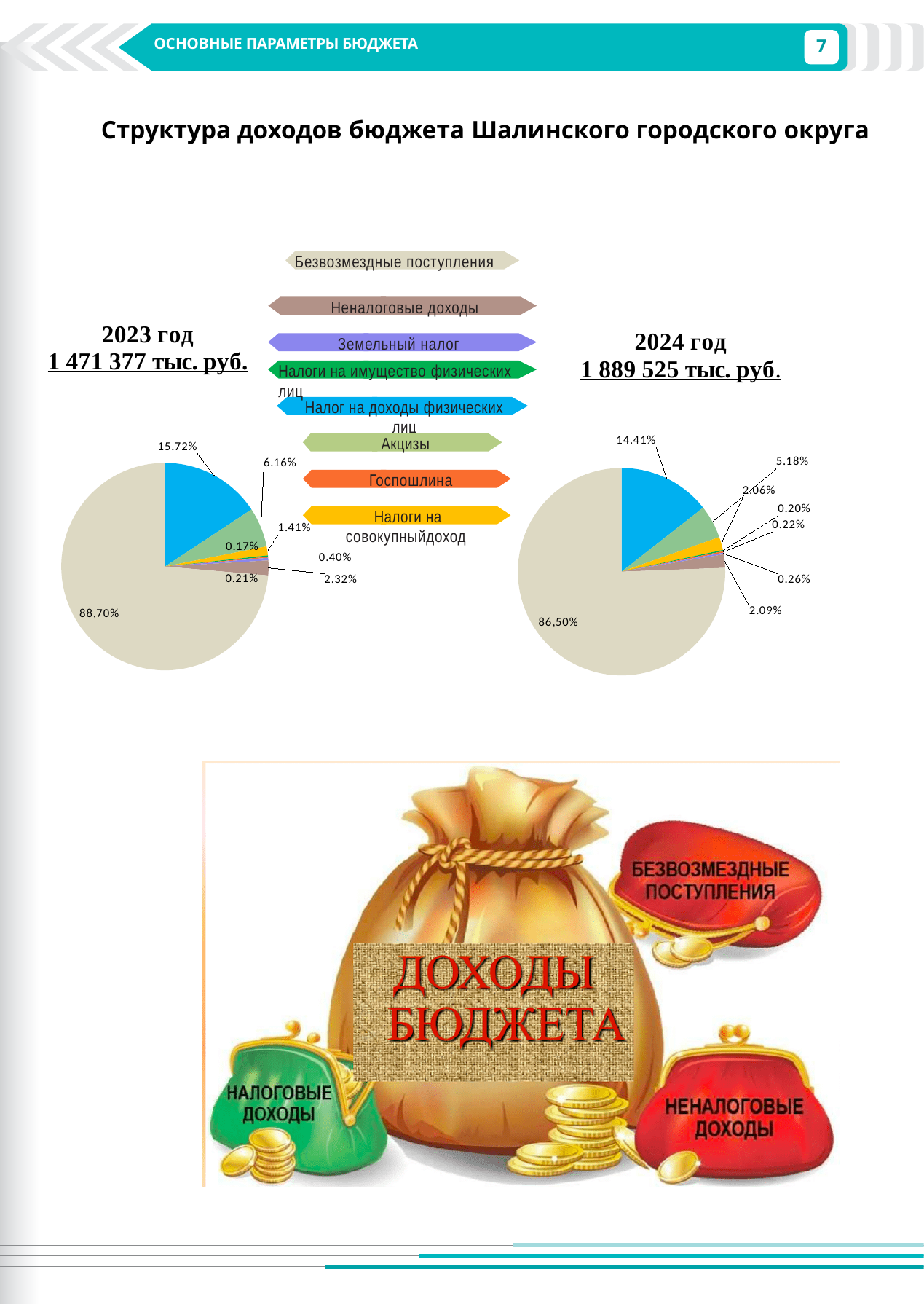
In the 2024 pie chart, what share is shown for Неналоговые доходы? 2.09% In the 2023 pie chart, what is the difference between the shares for Налог на доходы физических лиц (15.72%) and Акцизы (6.16%)? 9.56% In the 2023 pie chart, which is larger: the slice for Налог на доходы физических лиц or the slice for Акцизы? Налог на доходы физических лиц In the 2023 pie chart, what share is shown for Налог на доходы физических лиц? 15.72% How many categories does the shared legend between the two pie charts list? 8 What kind of charts are shown on the slide for 2023 and 2024? Pie charts In the 2024 pie chart, what share is shown for Налог на доходы физических лиц? 14.41% In the 2024 pie chart, which category has the largest slice? Безвозмездные поступления What total budget revenue is printed above the 2024 pie chart? 1 889 525 тыс. руб.